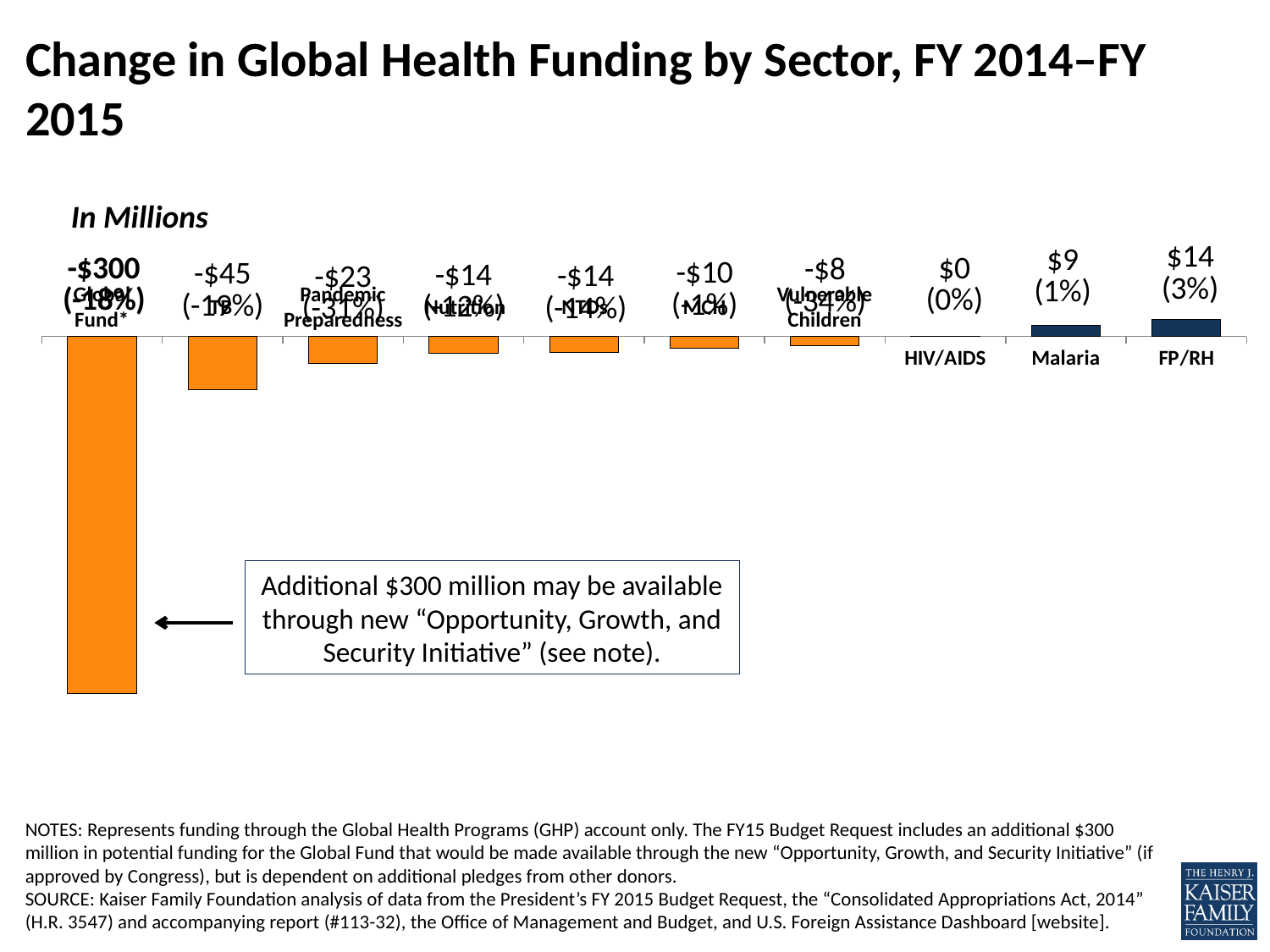
How many sectors are shown in the chart? 10 What is the change in funding for Vulnerable Children? -$8 What is the change in funding for the Global Fund*? -$300 Which sector has the largest decrease in funding? Global Fund* What is the change in funding for Malaria? $9 What percentage change is shown for the Global Fund*? -18% Which sector has the largest increase in funding? FP/RH What is the change in funding for Pandemic Preparedness? -$23 What is the change in funding for HIV/AIDS? $0 What is the difference between the funding change for FP/RH and for Malaria? $5 Which has a larger funding change, Malaria or FP/RH? FP/RH What is the change in funding for FP/RH? $14